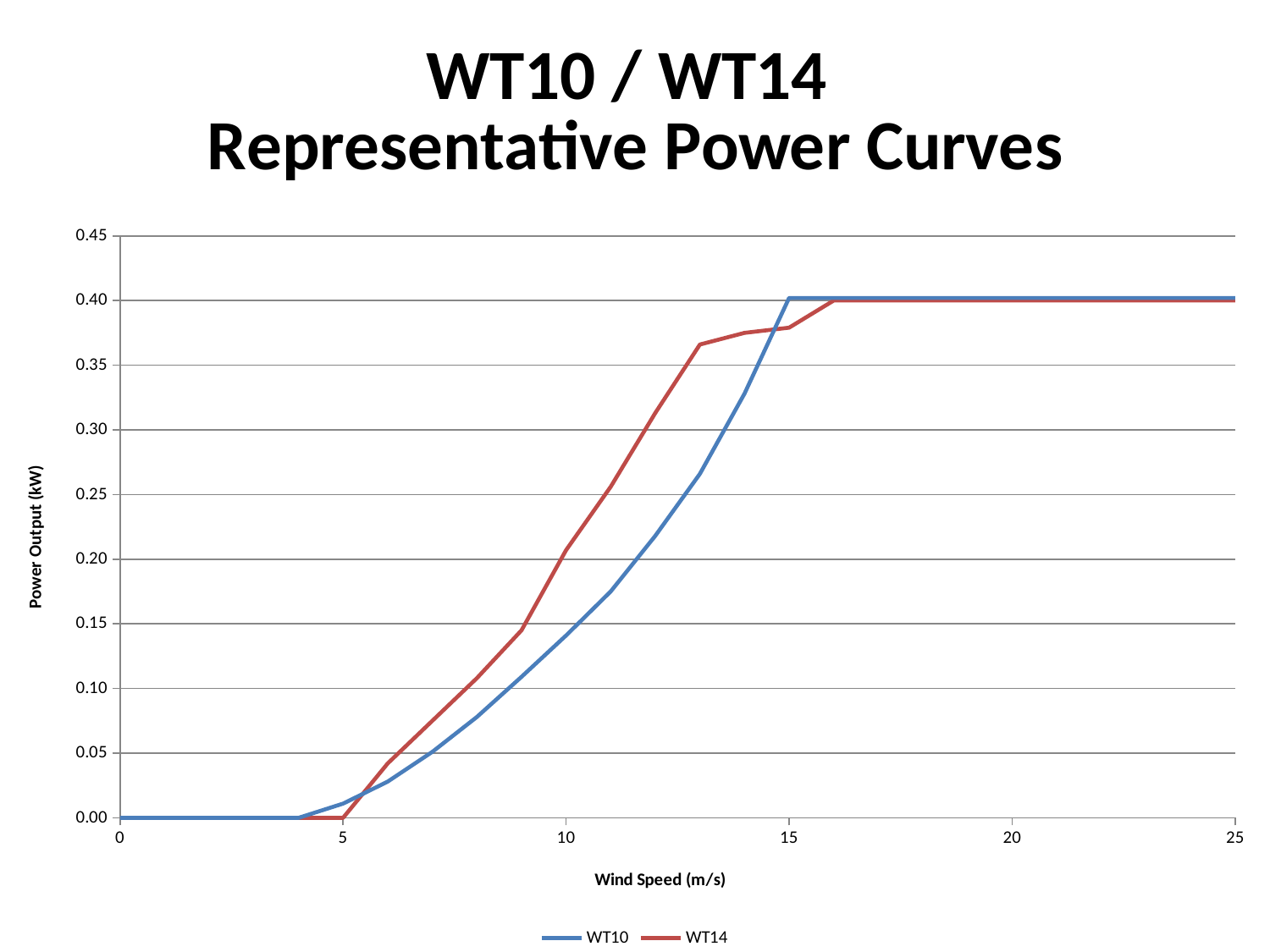
At a wind speed of 13 m/s, which series has the higher power output, WT10 or WT14? WT14 Is the power output for WT14 at 10 m/s greater or less than 0.15? greater What kind of chart is shown on the slide? line chart Is the power output for WT10 at 20 m/s greater or less than 0.35? greater What is the title of the x axis? Wind Speed (m/s) Between 5 m/s and 15 m/s, does the WT10 power output rise or fall as wind speed increases? rise Is the power output for WT14 at 7 m/s greater or less than 0.10? less At a wind speed of 10 m/s, which series has the higher power output, WT10 or WT14? WT14 What is the power output for WT10 at a wind speed of 2 m/s? 0.00 What are the two series named in the legend? WT10 and WT14 How many series does the legend list? 2